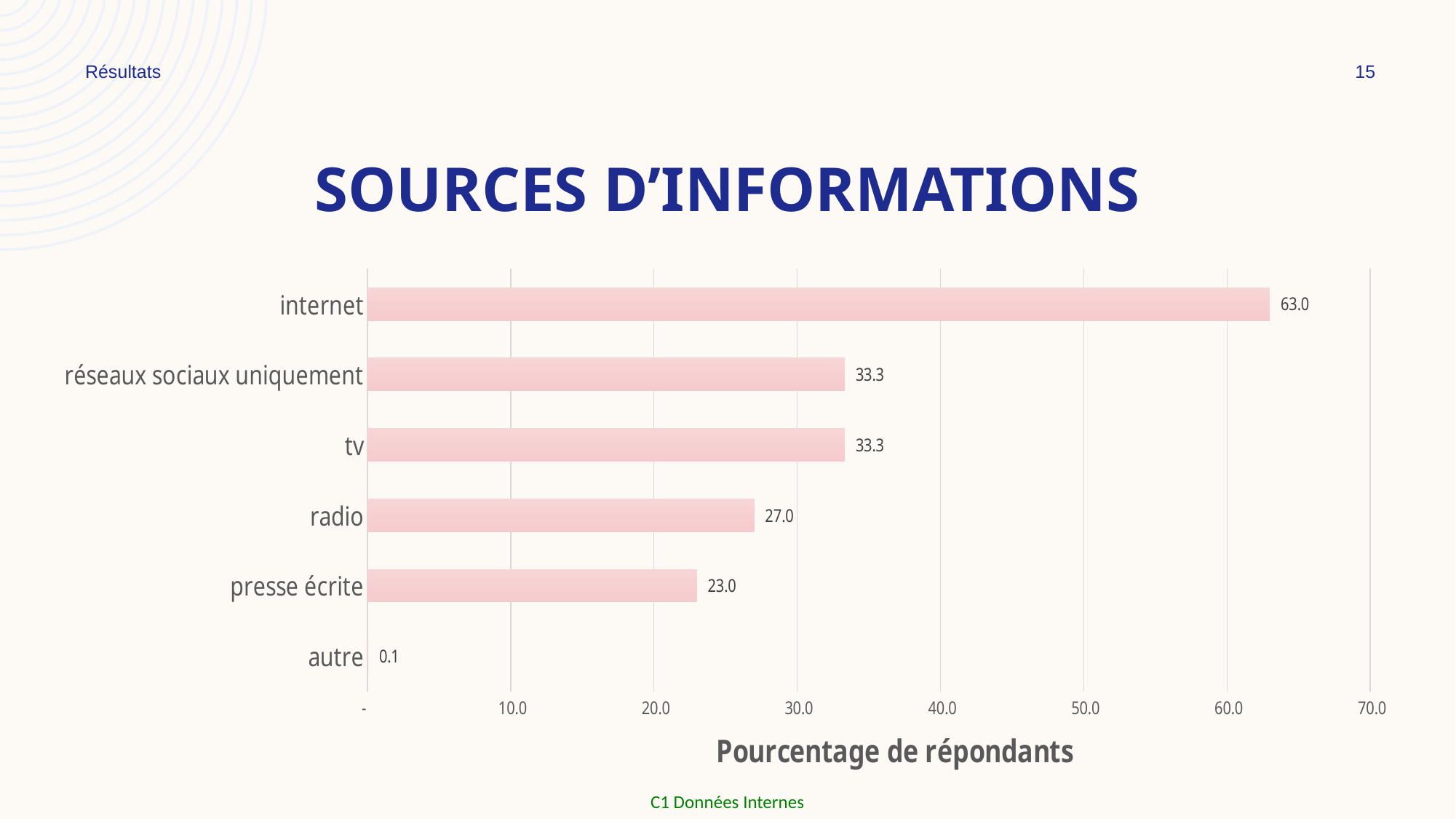
What kind of chart is shown on the slide? bar chart What is the value for internet? 63.0 Is the value for tv greater or less than 30.0? greater What is the label of the horizontal axis? Pourcentage de répondants What is the value for autre? 0.1 How many categories are shown in the chart? 6 What is the value for presse écrite? 23.0 What is the value for radio? 27.0 Which category has the highest value? internet What is the difference between the values for internet and radio? 36.0 Which category has the lowest value? autre Which is larger, the value for radio or the value for presse écrite? radio